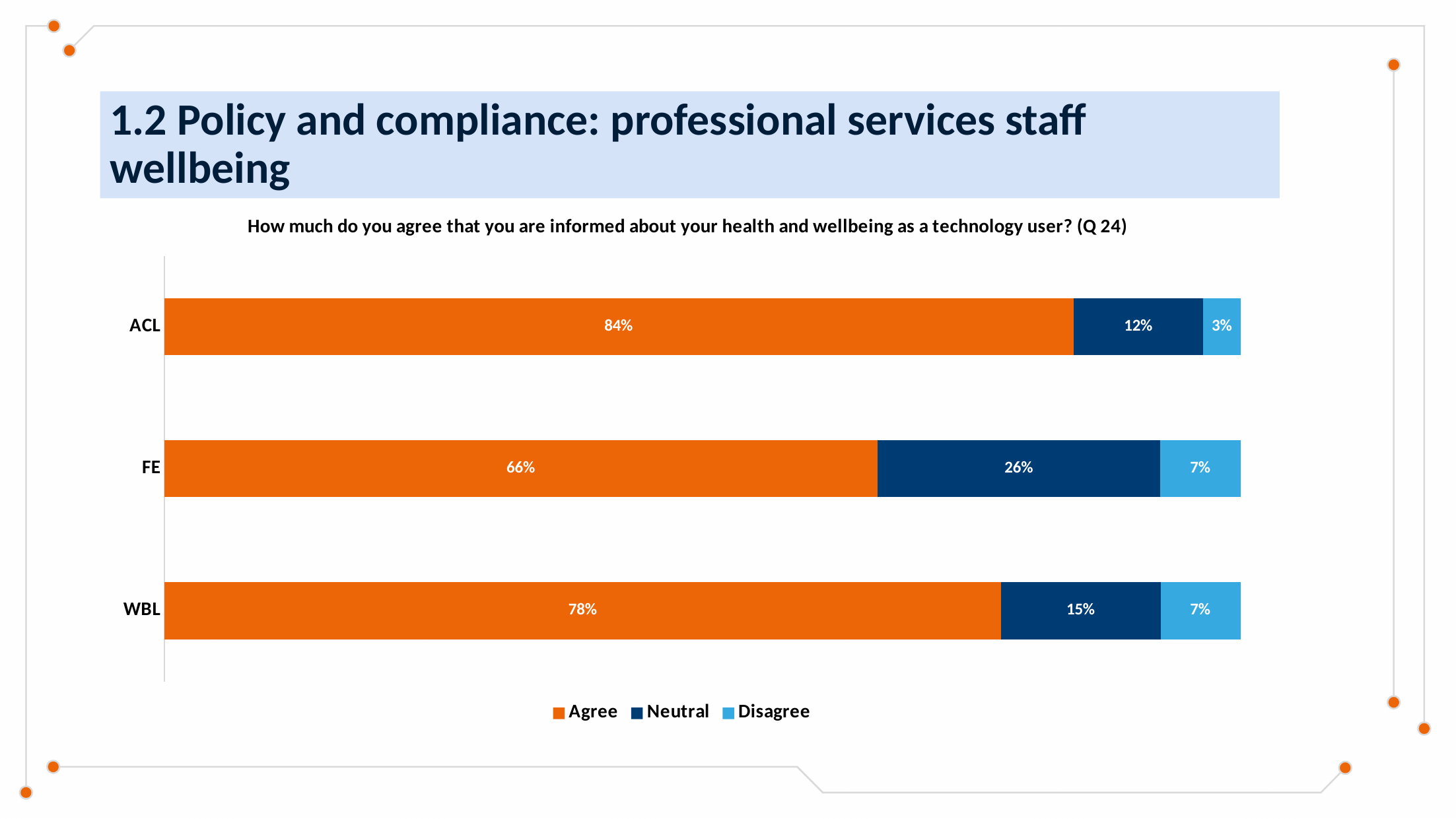
Which is larger, the Neutral value for WBL or the Neutral value for FE? FE Which series is shown in orange? Agree How many categories are shown on the chart? 3 What is the Disagree value for ACL? 3% What is the difference between the Agree percentages for ACL and FE? 18% What is the Neutral value for FE? 26% What kind of chart is shown on the slide? Stacked bar chart Which category has the lowest Agree percentage? FE Which category has the highest Agree percentage? ACL What is the Disagree value for WBL? 7% How many series does the legend list? 3 What percentage of ACL respondents agree that they are informed about their health and wellbeing as a technology user? 84%